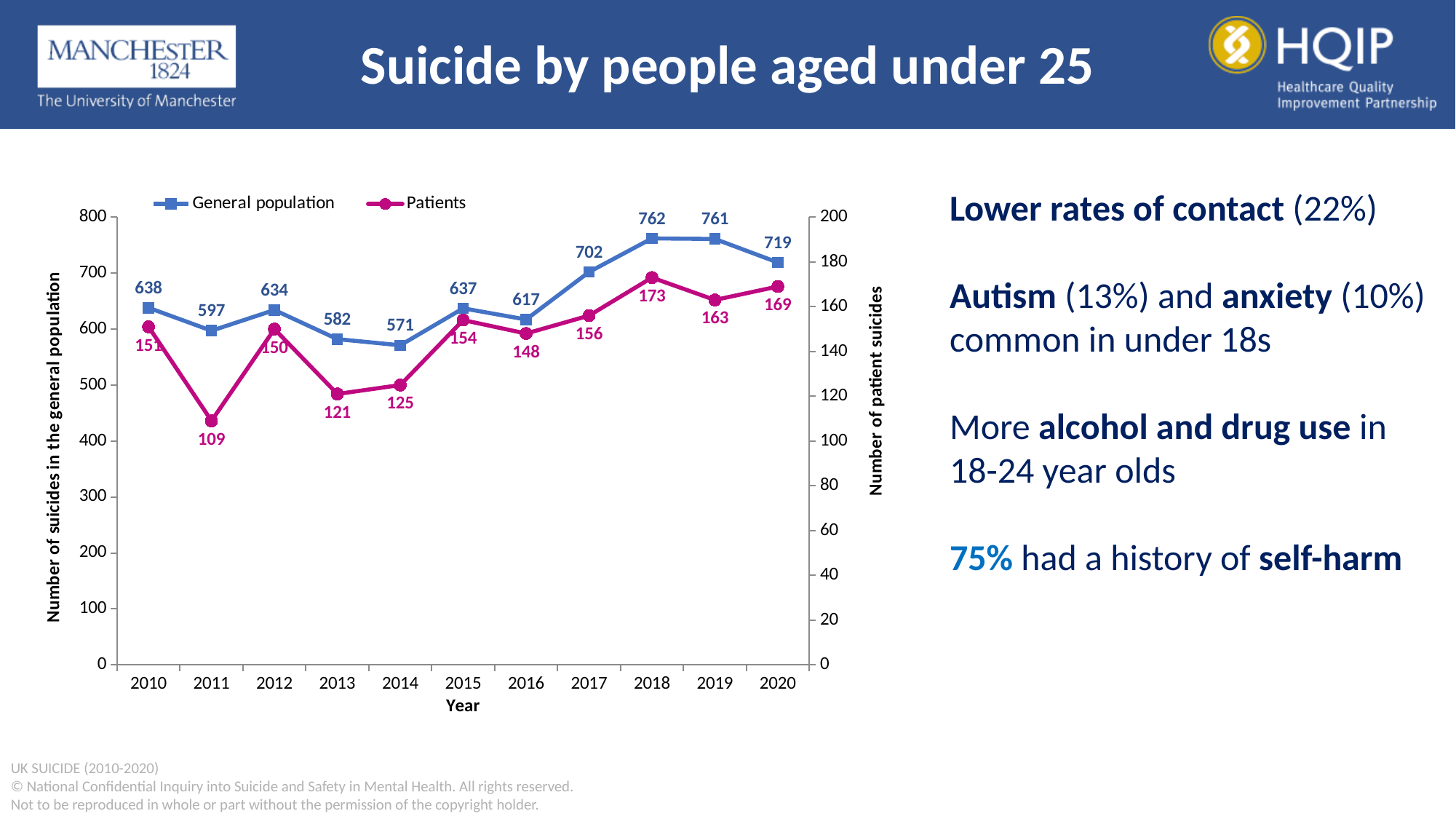
What is the label of the x axis? Year What is the difference between the Patients values in 2018 and 2011? 64 What is the value for the General population series in 2018? 762 What is the value for the Patients series in 2011? 109 In which year is the General population series lowest? 2014 What is the difference between the General population values in 2018 and 2010? 124 Which is larger for the Patients series: the value in 2019 or the value in 2020? 2020 Does the General population series rise or fall from 2014 to 2018? Rise How many years are plotted on the x axis? 11 What type of chart is shown on the slide? Line chart How many series does the legend list? 2 In which year is the Patients series highest? 2018